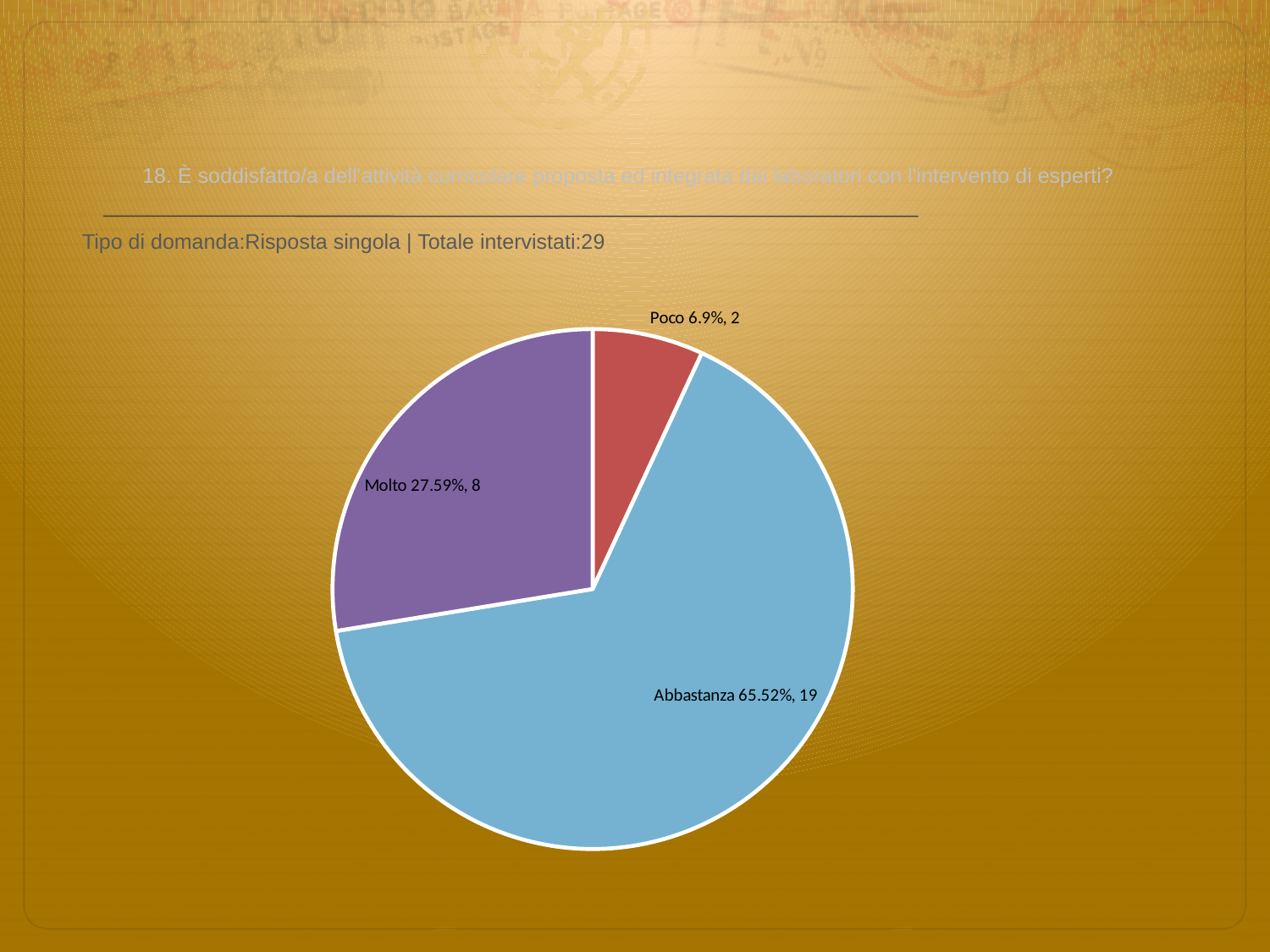
What percentage share does the Molto slice have? 27.59% Which category has the largest slice? Abbastanza What is the difference in respondent count between Abbastanza and Molto? 11 What kind of chart is shown on the slide? pie chart How many respondents chose Abbastanza? 19 What percentage share does the Abbastanza slice have? 65.52% What percentage share does the Poco slice have? 6.9% Which category has the smallest slice? Poco Which has more respondents, Molto or Poco? Molto How many slices does the pie chart have? 3 How many respondents chose Molto? 8 How many respondents chose Poco? 2